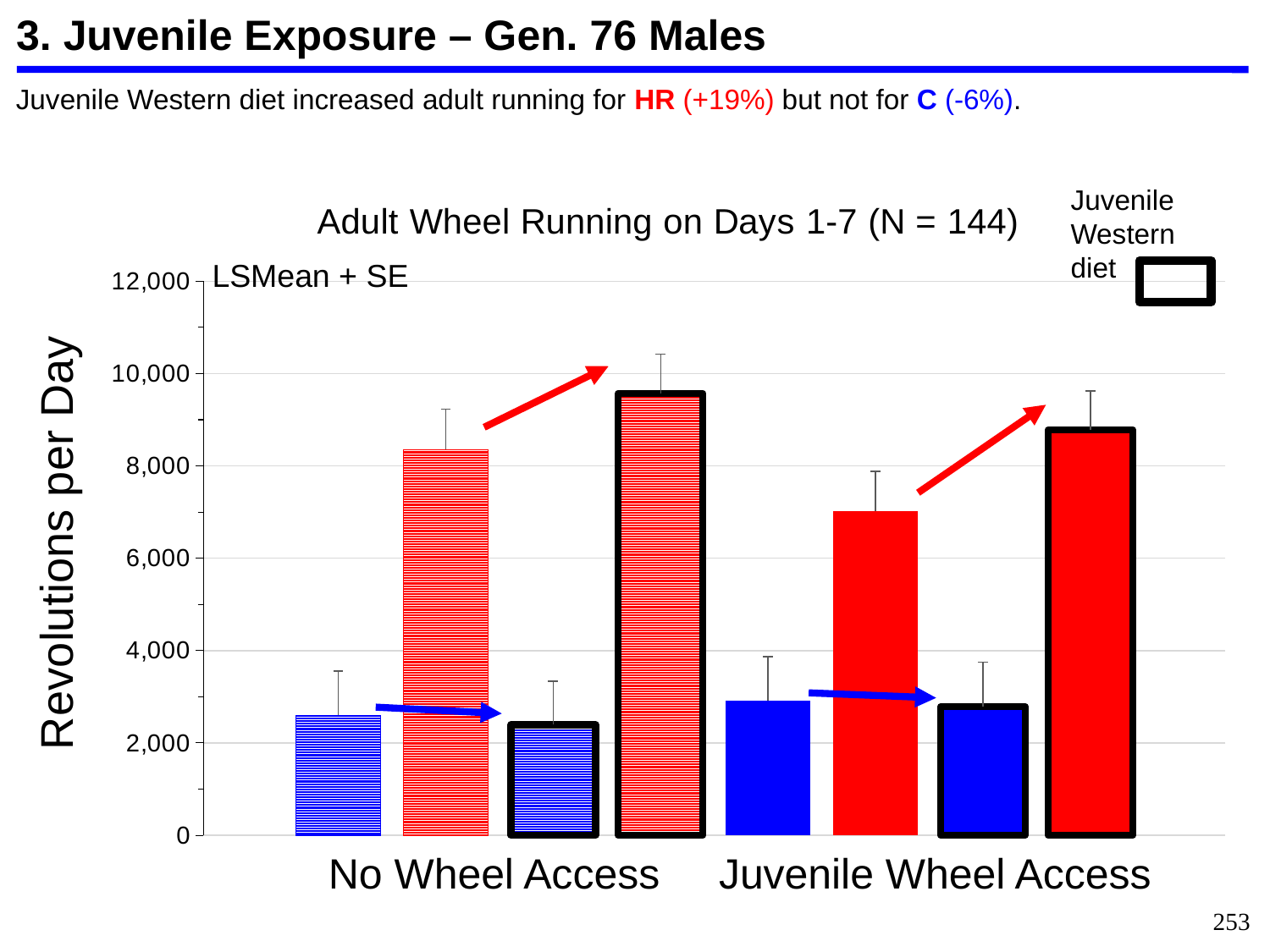
What is the title of the chart? Adult Wheel Running on Days 1-7 (N = 144) Is the value of the tallest bar in the Juvenile Wheel Access group greater or less than 10,000? less What is the highest value shown on the y axis of the chart? 12,000 Is the value of the tallest bar in the No Wheel Access group greater or less than 8,000? greater How many categories are shown on the x axis of the chart? 2 What is the label on the y axis of the chart? Revolutions per Day What kind of chart is shown on the slide? bar chart Is the value of the solid red bar (no black outline) in the Juvenile Wheel Access group greater or less than 6,000? greater In the Juvenile Wheel Access group, which is larger: the solid red bar or the solid blue bar? the solid red bar In the No Wheel Access group, which is larger: the red bar with the black outline or the red bar without the outline? the red bar with the black outline Which x-axis group contains the tallest bar on the chart? No Wheel Access